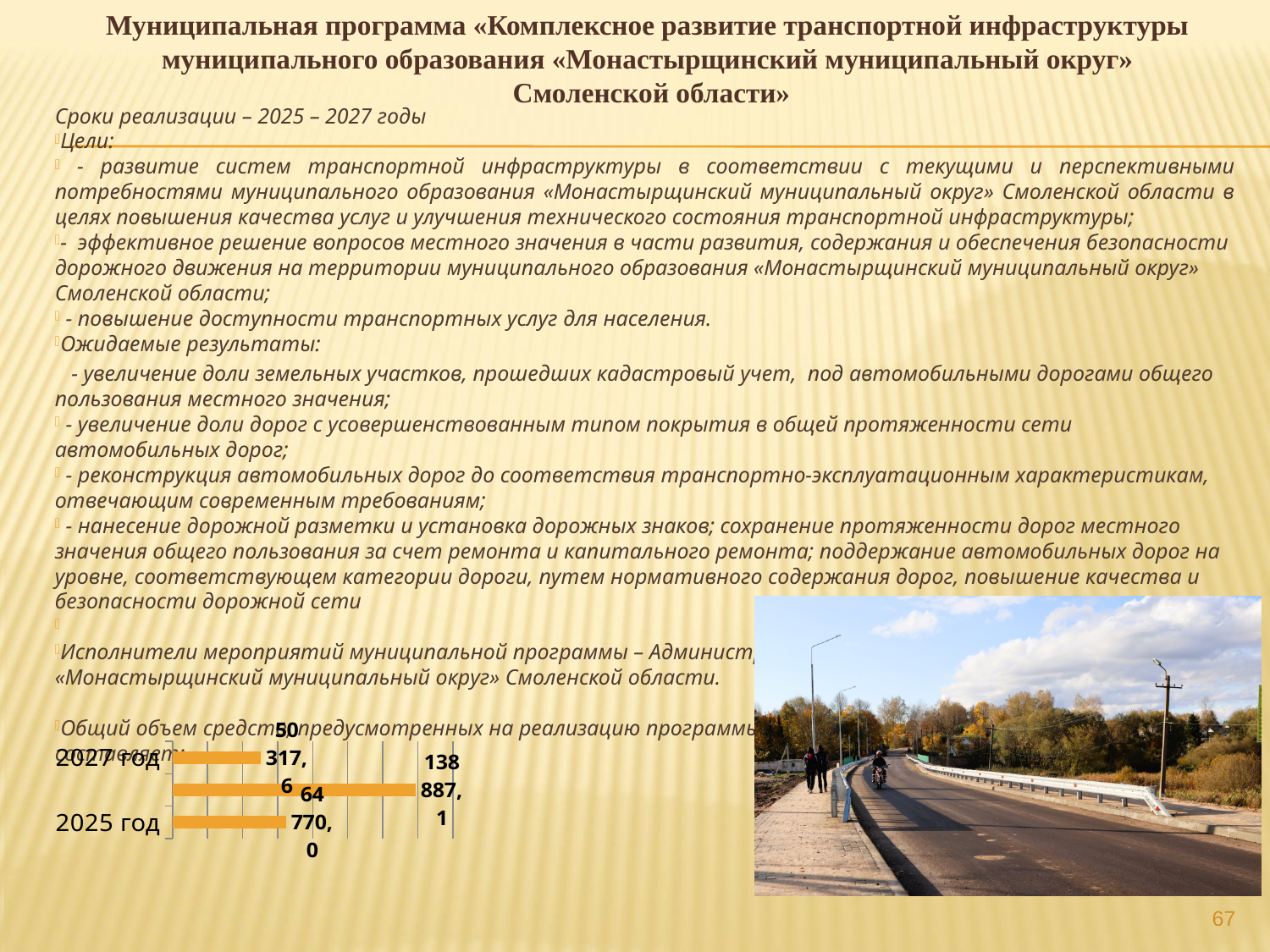
In the chart at the bottom left, what is the difference between the values for 2025 год and 2027 год? 14 452,4 What colour are the bars in the chart at the bottom left of the slide? orange In the chart at the bottom left, what is the value shown on the longest (middle) bar? 138 887,1 In the chart at the bottom left, are the bars drawn horizontally or vertically? horizontally In the chart at the bottom left, what is the value for 2027 год? 50 317,6 In the chart at the bottom left, which has the larger value, 2025 год or 2027 год? 2025 год What kind of chart is shown at the bottom left of the slide? bar chart In the chart at the bottom left, what is the value for 2025 год? 64 770,0 In the chart at the bottom left, which of the labelled years, 2025 год or 2027 год, has the smaller value? 2027 год How many bars does the chart at the bottom left of the slide have? 3